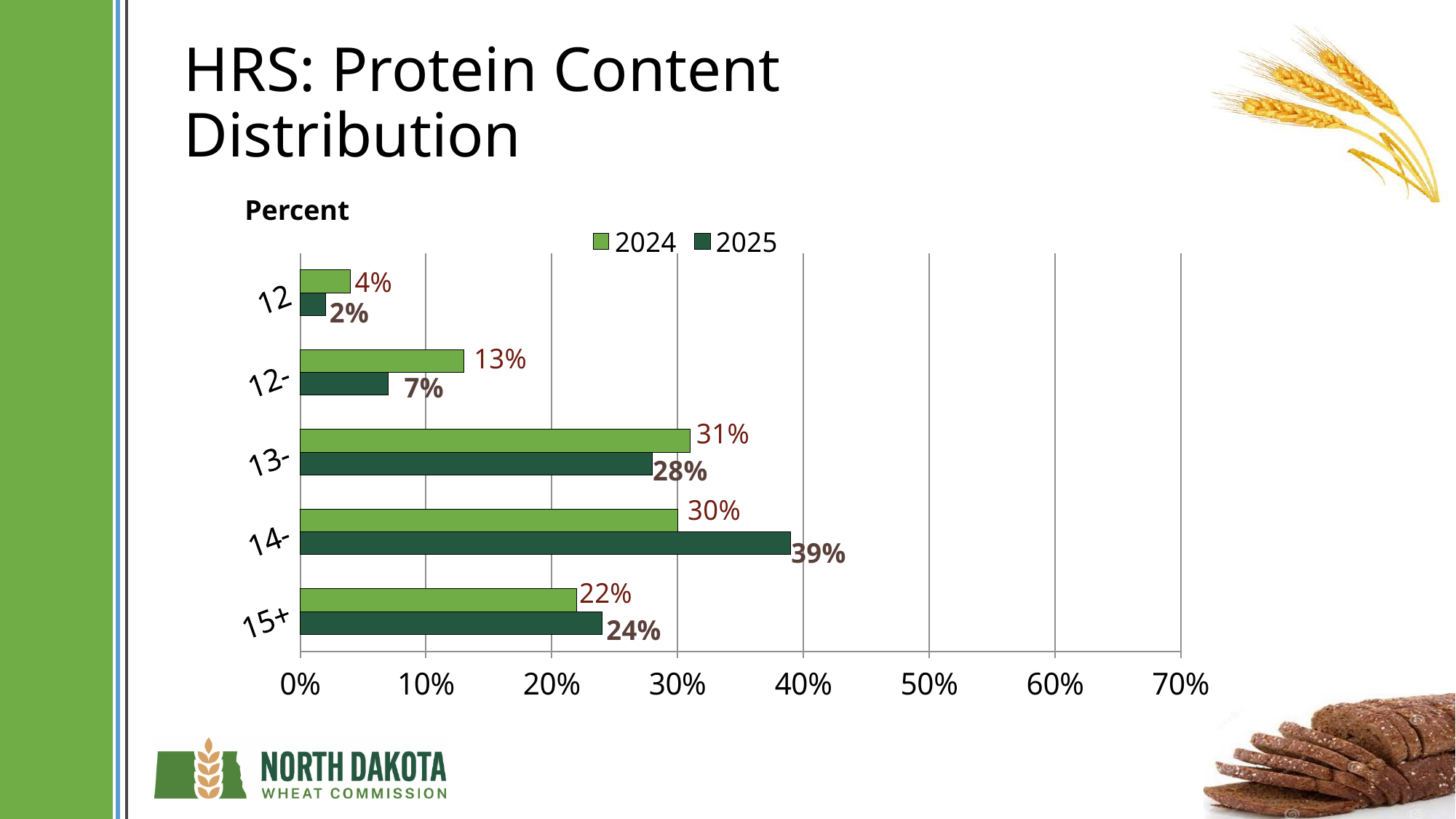
Which protein category has the lowest 2024 value? 12 What is the 2025 value for the 14- protein category? 39% What is the 2024 value for the 13- protein category? 31% How many series does the legend list? 2 What is the 2025 value for the 15+ protein category? 24% What is the title of the slide? HRS: Protein Content Distribution Which is larger for the 12- category, the 2024 value or the 2025 value? 2024 What kind of chart is shown on the slide? Bar chart How many protein categories are shown on the chart? 5 What is the difference between the 2025 and 2024 values for the 14- category? 9% Is the 2025 value for the 13- category greater or less than 20%? greater Which protein category has the highest 2025 value? 14-